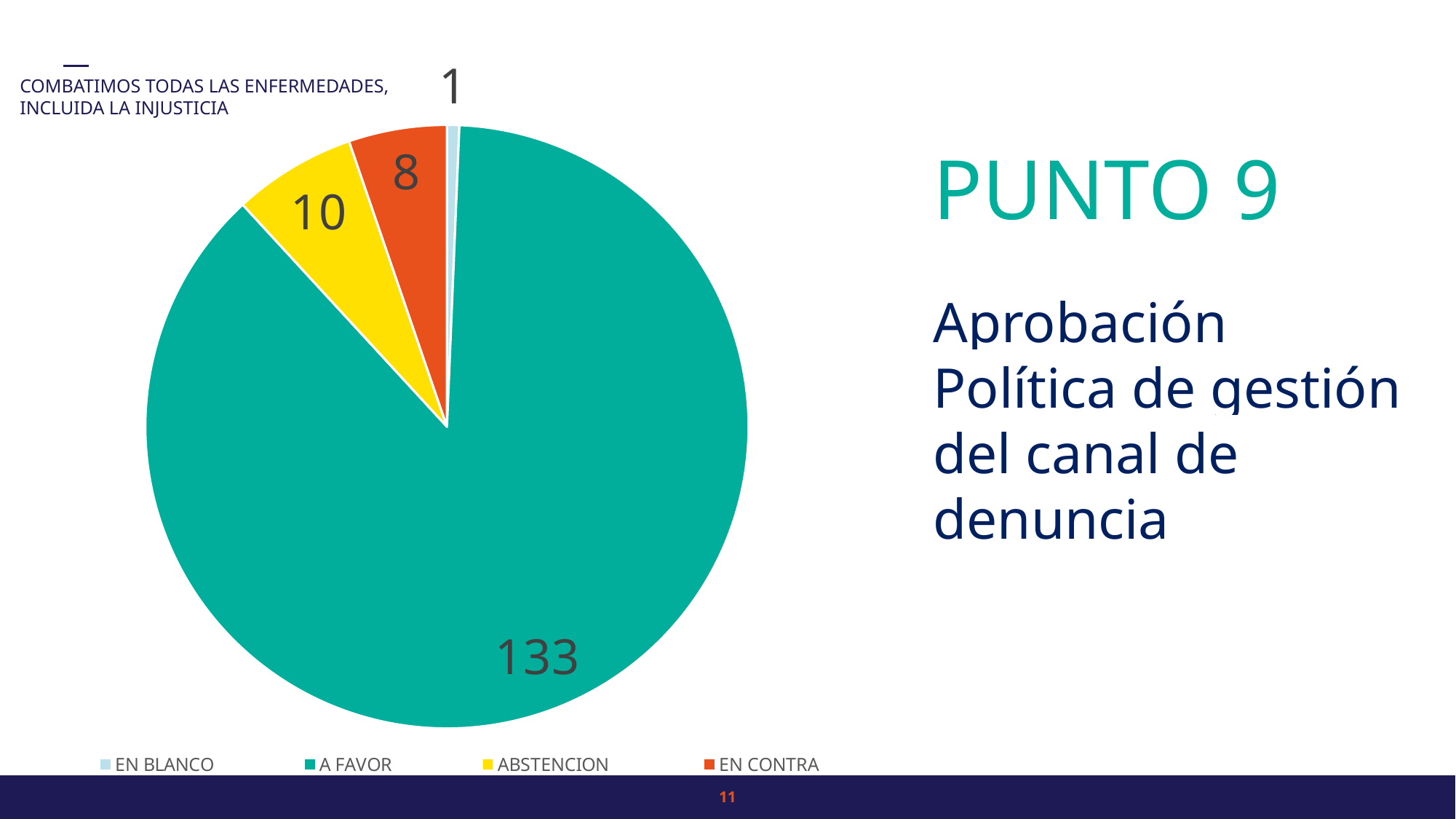
Which is larger, ABSTENCION or EN CONTRA? ABSTENCION What is the value of the ABSTENCION slice? 10 What type of chart is shown on the slide? Pie chart Which category has the smallest slice of the pie? EN BLANCO What is the total of all the slices in the pie chart? 152 How many votes does the A FAVOR slice represent? 133 What is the value of the EN BLANCO slice? 1 Which category has the largest slice of the pie? A FAVOR Which colour represents the A FAVOR category in the pie chart? Teal What is the difference between the A FAVOR and ABSTENCION values? 123 How many categories does the pie chart have? 4 What is the value of the EN CONTRA slice? 8